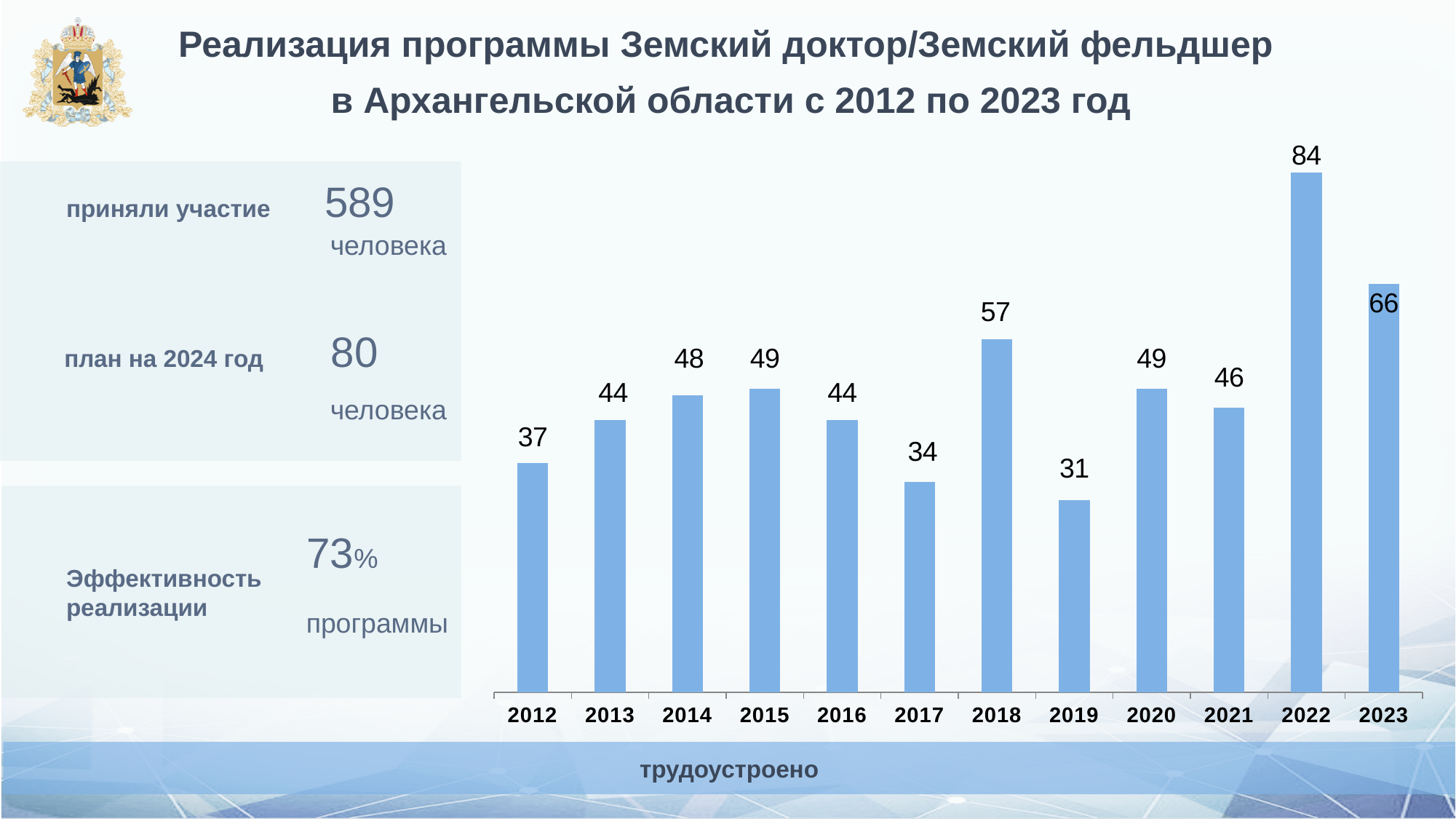
How many years are shown on the x axis? 12 Do the values rise or fall from 2019 to 2022? rise What is the value for 2023? 66 Which year has the highest value? 2022 What label appears below the chart's x axis? трудоустроено What is the value for 2012? 37 What is the difference between the values for 2018 and 2019? 26 What kind of chart is shown? bar chart What is the difference between the values for 2022 and 2023? 18 Which is larger, the value for 2014 or the value for 2017? 2014 What is the value for 2018? 57 Which year has the lowest value? 2019